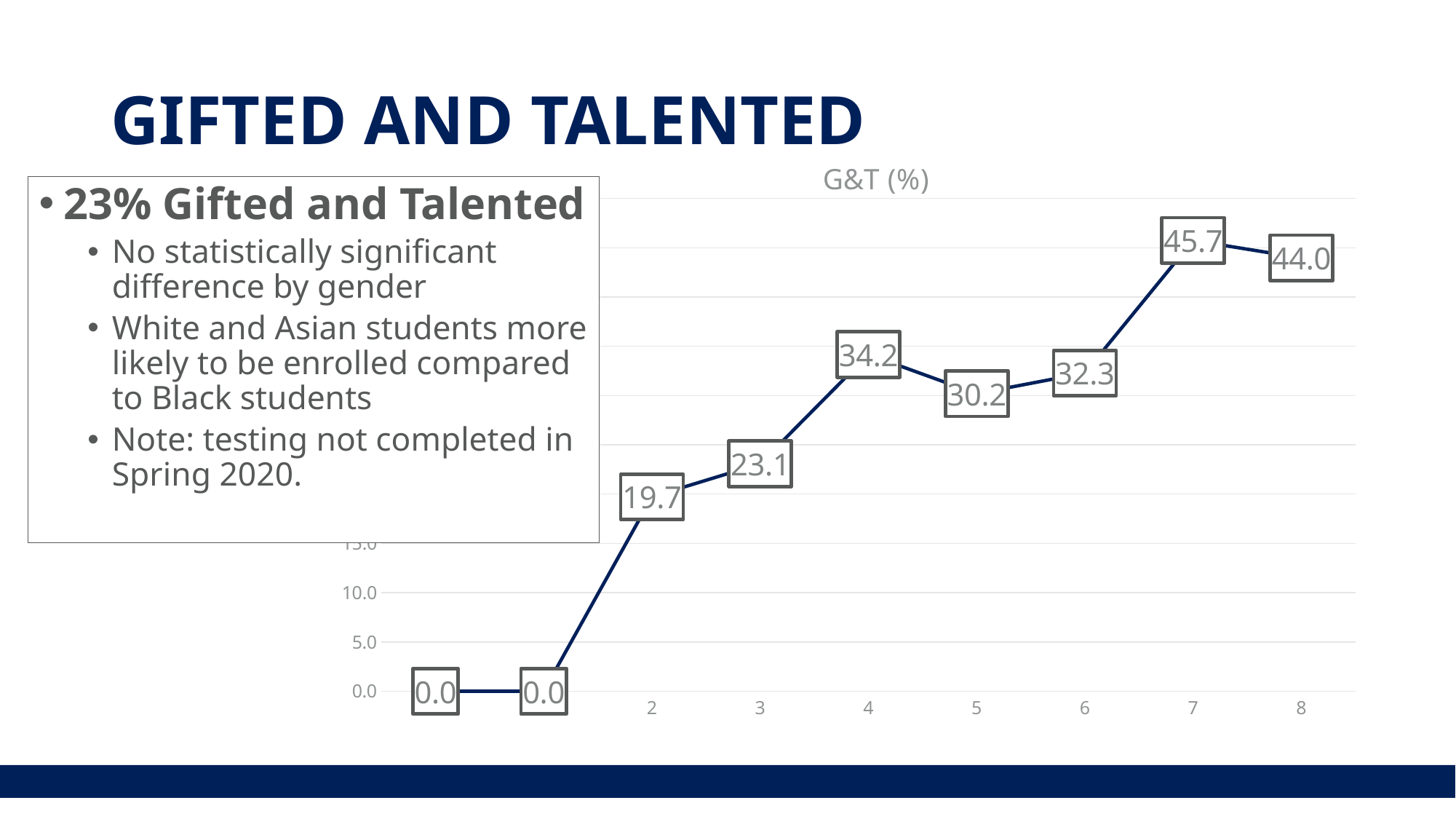
What is the difference between the G&T (%) values for grade 7 and grade 8? 1.7 How many data points are plotted on the line? 9 What is the G&T (%) value for grade 7? 45.7 What is the G&T (%) value for grade 8? 44.0 What is the G&T (%) value for grade 2? 19.7 What is the lowest value plotted on the chart? 0.0 Does the G&T (%) value rise or fall from grade 4 to grade 5? fall Which grade on the x axis has the highest G&T (%) value? 7 What is the title of the chart? G&T (%) What kind of chart is shown on the slide? line chart Which has a larger G&T (%) value, grade 5 or grade 6? grade 6 What is the G&T (%) value for grade 4? 34.2